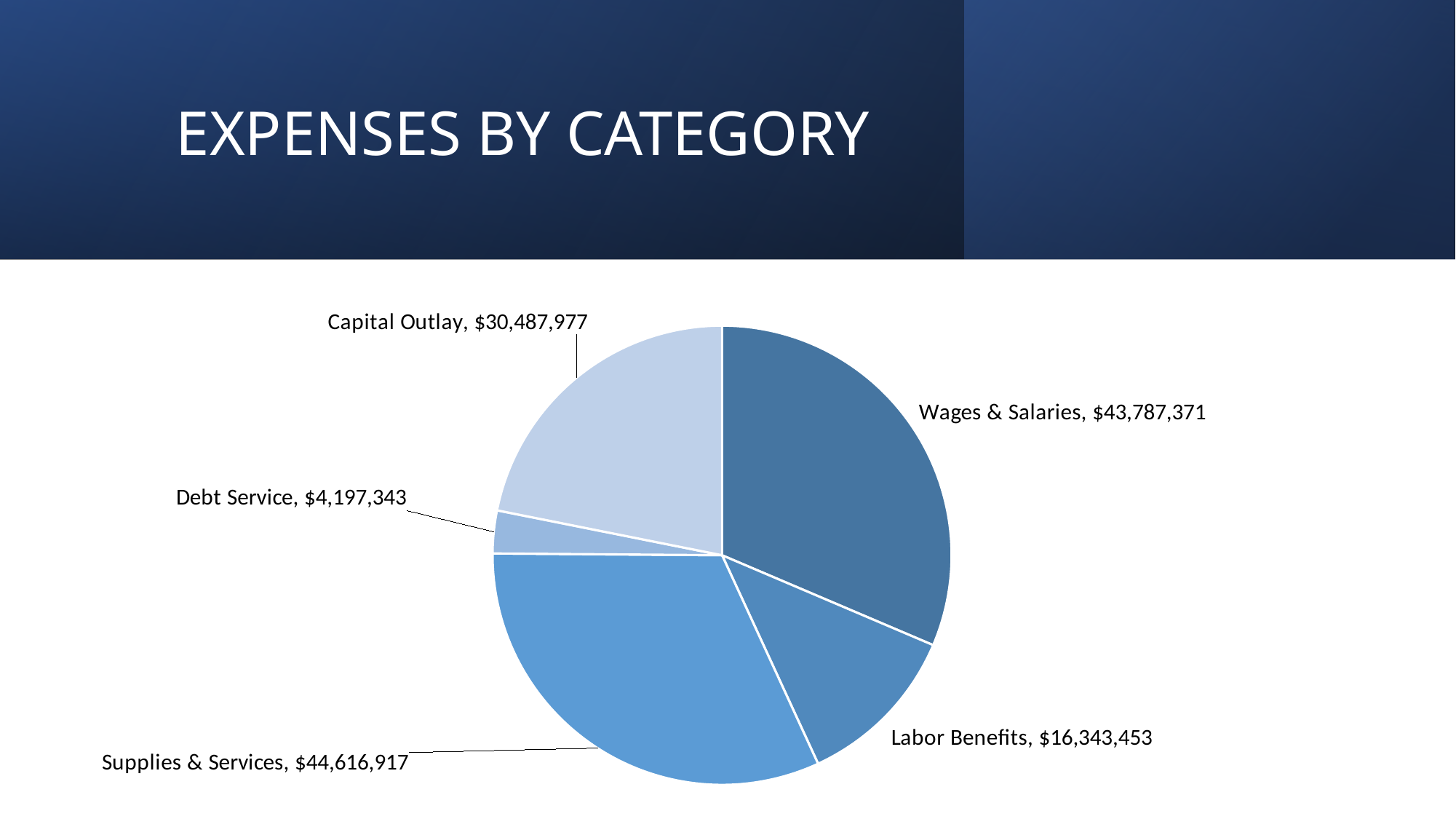
What is the value for Wages & Salaries? $43,787,371 What is the difference between Capital Outlay and Debt Service? $26,290,634 What is the difference between Wages & Salaries and Labor Benefits? $27,443,918 What is the value for Debt Service? $4,197,343 What is the title of the slide? EXPENSES BY CATEGORY How many categories are shown in the pie chart? 5 What is the value for Capital Outlay? $30,487,977 What kind of chart is shown on the slide? Pie chart Which category has the smallest expense? Debt Service Which category has the largest expense? Supplies & Services Which is larger, Labor Benefits or Capital Outlay? Capital Outlay What is the total of all expense categories shown? $139,433,061